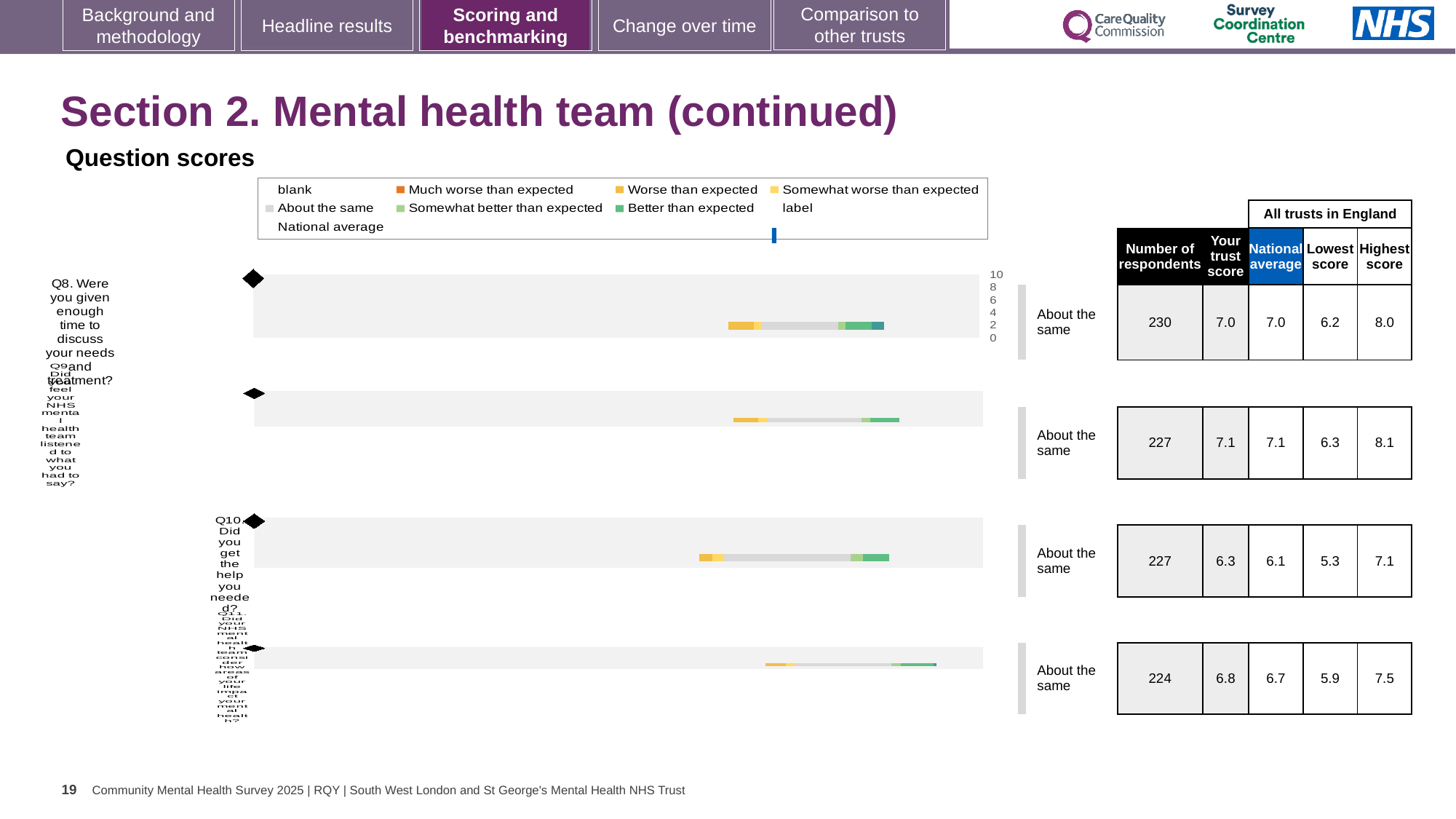
What benchmark rating is shown next to the Q8 chart? About the same What is the national average for Q10 (Did you get the help you needed?)? 6.1 How many categories does the legend list for the question score charts? 9 Which legend entry is shown in orange? Much worse than expected What is the trust score for Q8 (Were you given enough time to discuss your needs and treatment?)? 7.0 What is the difference between the highest score and the lowest score for Q9? 1.8 What kind of chart is used for each question score on the slide? bar chart Which question has the lowest trust score among Q8, Q9, Q10 and Q11? Q10 Which question has the highest trust score among Q8, Q9, Q10 and Q11? Q9 How many question charts are shown on the slide? 4 How many respondents answered Q11? 224 Which legend entry is shown in grey? About the same